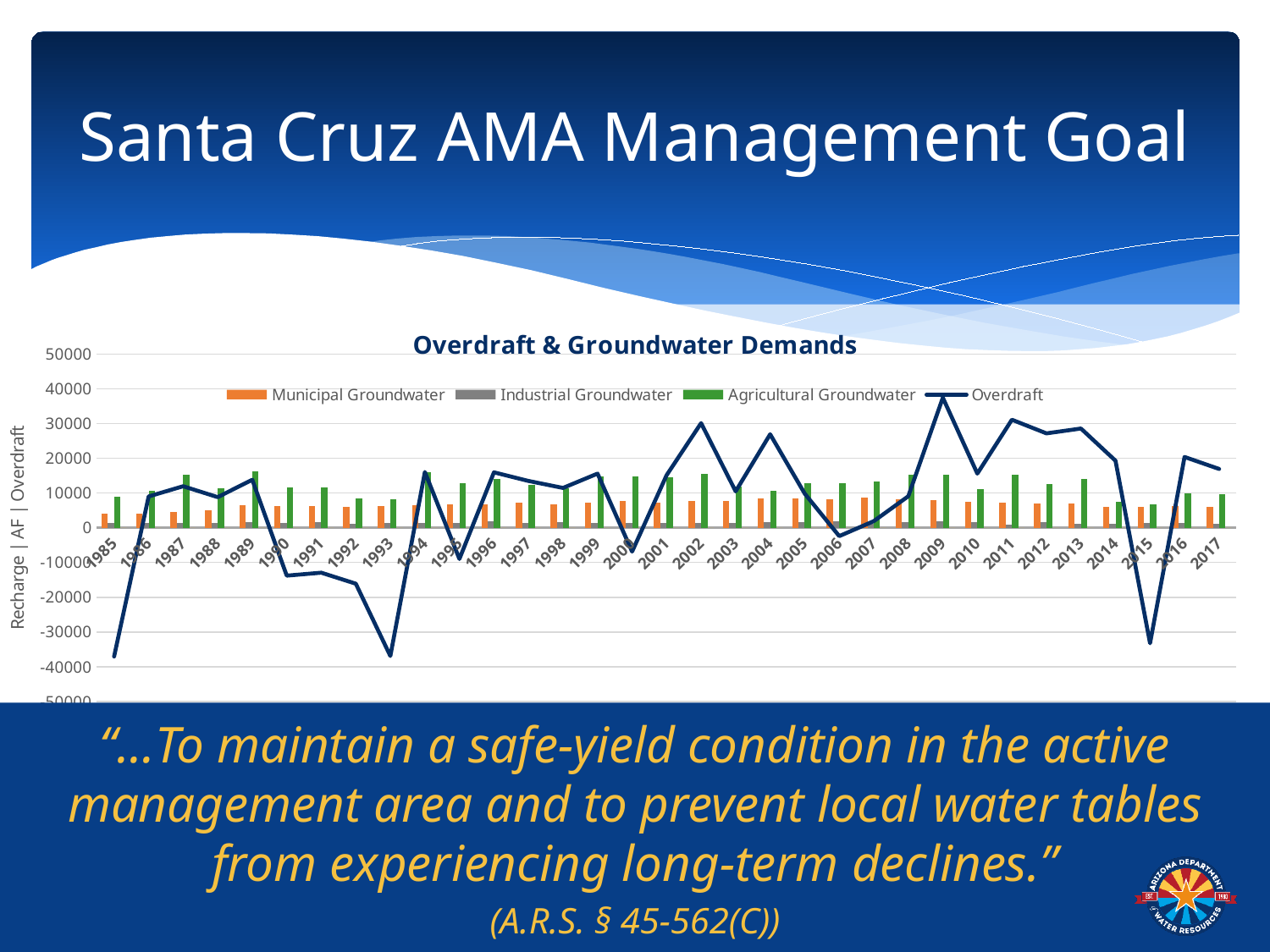
What kind of chart is shown on the slide? Combined bar and line chart How many series does the chart legend list? 4 Which series is plotted as a line rather than bars? Overdraft In which year does the Overdraft line reach its highest value? 2009 Is the Overdraft value for 2009 greater or less than 30000? greater Is the Overdraft value for 1985 greater or less than -30000? less Does the Overdraft line rise or fall from 2014 to 2015? fall Which is larger in 1987, Agricultural Groundwater or Municipal Groundwater? Agricultural Groundwater What is the title of the chart? Overdraft & Groundwater Demands Is the Overdraft value for 2015 greater or less than -30000? less How many years are shown along the x axis of the chart? 33